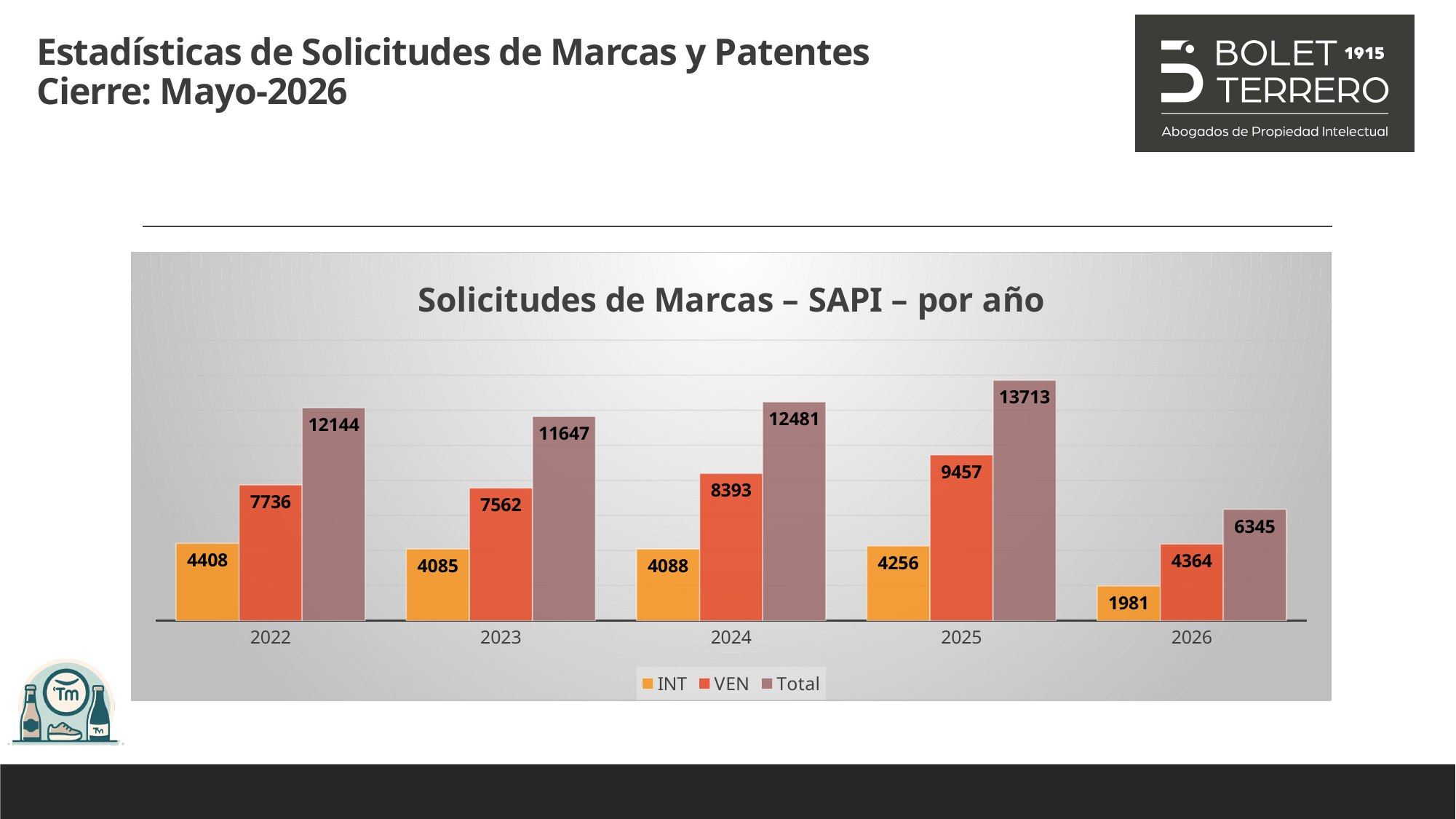
What is the Total value for 2026? 6345 How many series does the legend list? 3 What is the VEN value for 2025? 9457 Does the Total value rise or fall from 2025 to 2026? fall Which is larger, the INT value for 2022 or the INT value for 2025? 2022 How many years are shown on the x axis? 5 What is the INT value for 2022? 4408 Which year has the highest Total value? 2025 What kind of chart is shown? bar chart What is the difference between the VEN values for 2024 and 2023? 831 Which year has the lowest INT value? 2026 What is the title of the chart? Solicitudes de Marcas – SAPI – por año